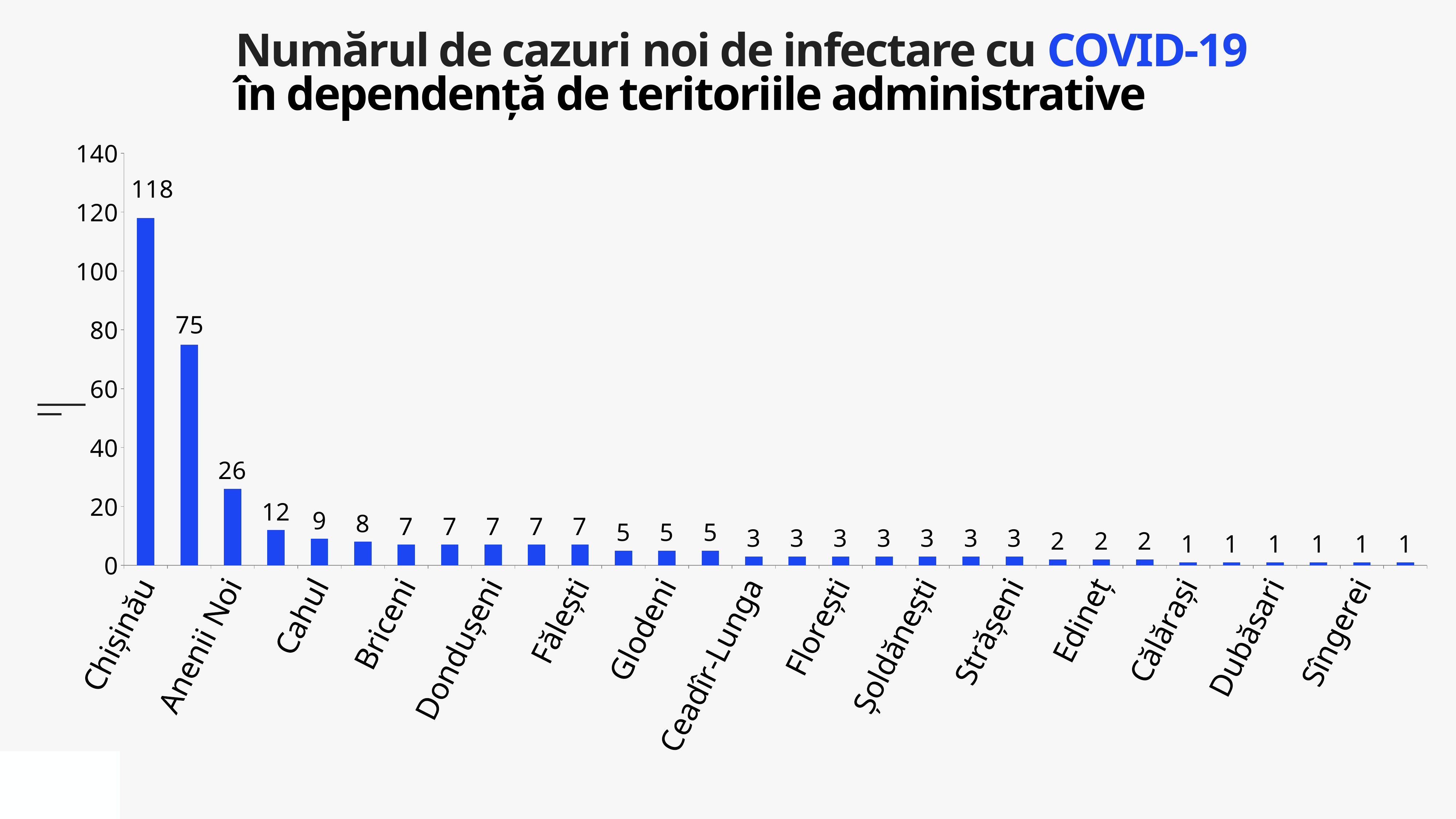
Which territory has the highest number of new COVID-19 cases? Chișinău What is the number of new cases for Sîngerei? 1 What is the number of new cases for Șoldănești? 3 What is the number of new cases for Chișinău? 118 How many bars are plotted in the chart? 30 What is the number of new cases for Edineț? 2 What type of chart is shown on the slide? bar chart What is the highest tick value shown on the vertical axis? 140 What is the number of new cases for Glodeni? 5 Is the value for Chișinău greater or less than 100? greater What is the difference between the highest value (118) and the second-highest value (75)? 43 Do the values rise or fall from left to right along the x axis? fall